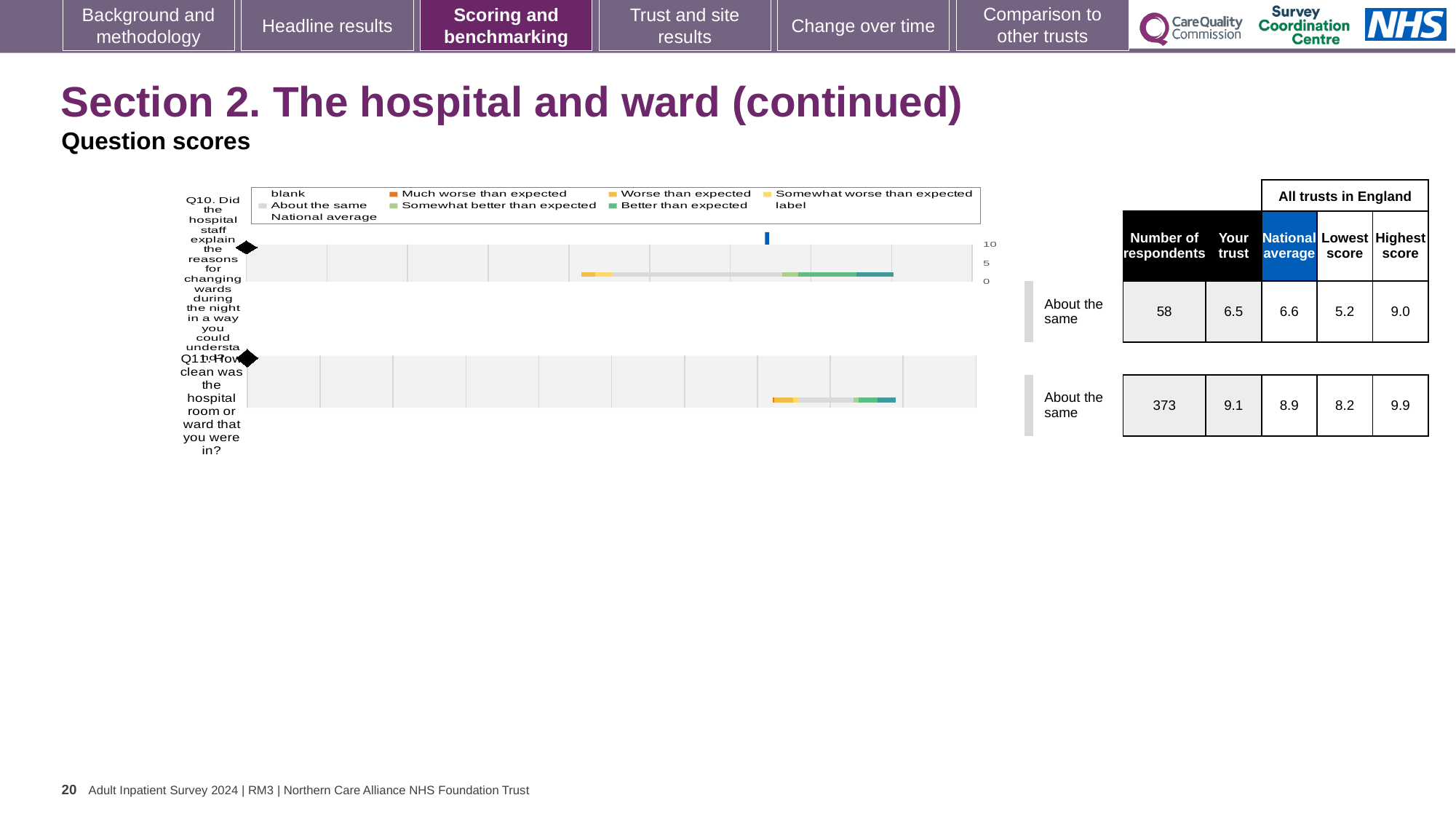
What is the number of respondents for Q10? 58 What is the difference between the highest and lowest scores for Q10? 3.8 What is the difference between the 'Your trust' score and the national average for Q11? 0.2 What is the national average score for Q10? 6.6 For Q10, which is larger: the 'Your trust' score or the national average? National average What benchmark category is shown for Q11 (How clean was the hospital room or ward)? About the same What is the highest score among all trusts in England for Q11? 9.9 What kind of chart is used to show the benchmarking for Q10 and Q11? bar chart What is the 'Your trust' score for Q11? 9.1 How many questions (Q10 and Q11) are plotted on the slide? 2 Which legend entry is shown in orange in the chart legend? Much worse than expected What benchmark category is shown for Q10 (Did the hospital staff explain the reasons for changing wards during the night)? About the same